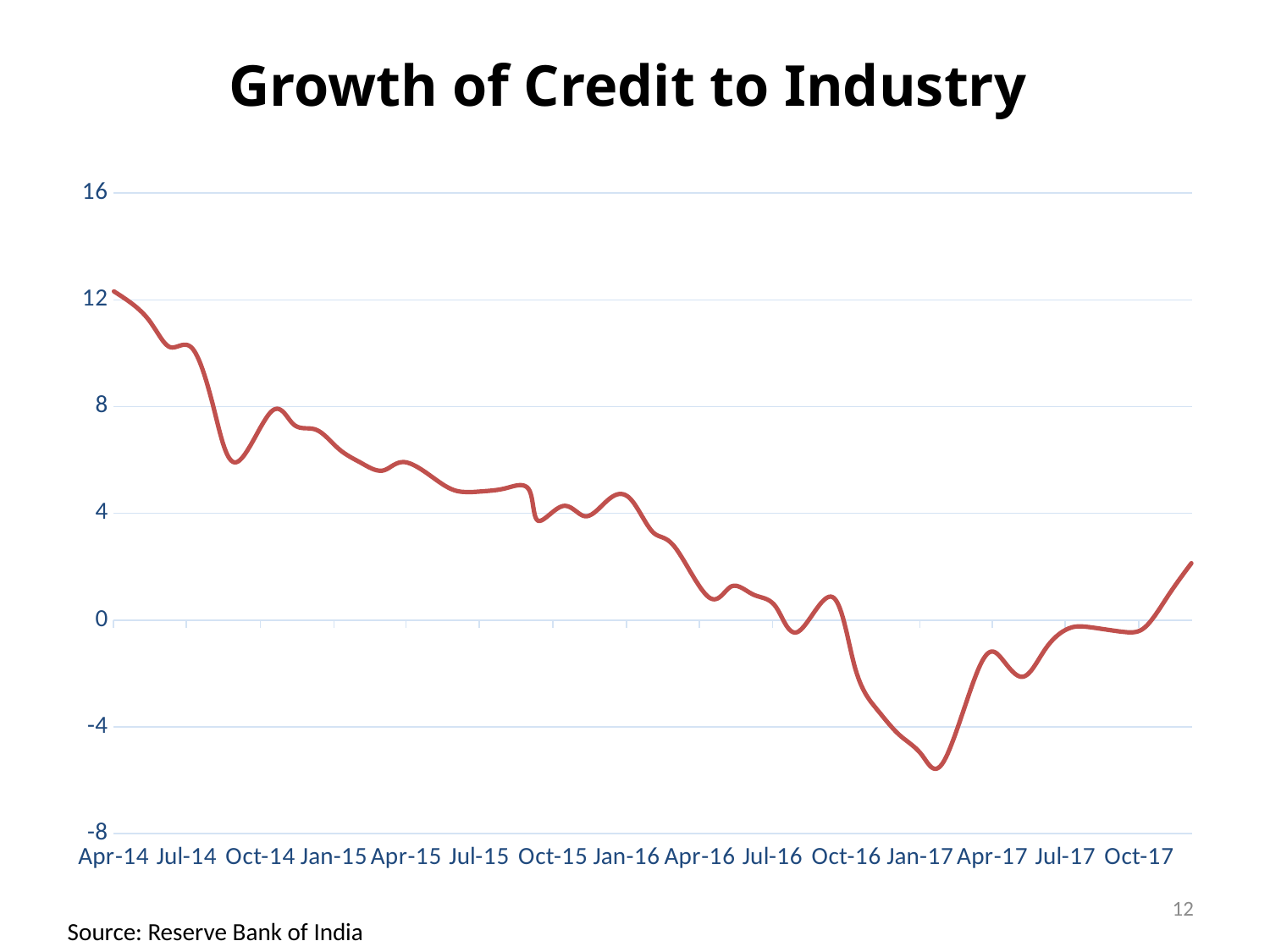
What source is cited for the chart? Reserve Bank of India Which is larger, the value for Apr-14 or the value for Jan-17? Apr-14 Is the value for Apr-15 greater or less than 4? greater Is the value for Jul-14 greater or less than 8? greater Is the value for Apr-16 greater or less than 4? less How many month labels are shown on the x axis? 15 Does the line generally rise or fall from Apr-14 to Jan-17? fall What kind of chart is shown on the slide? line chart What is the title of the chart? Growth of Credit to Industry